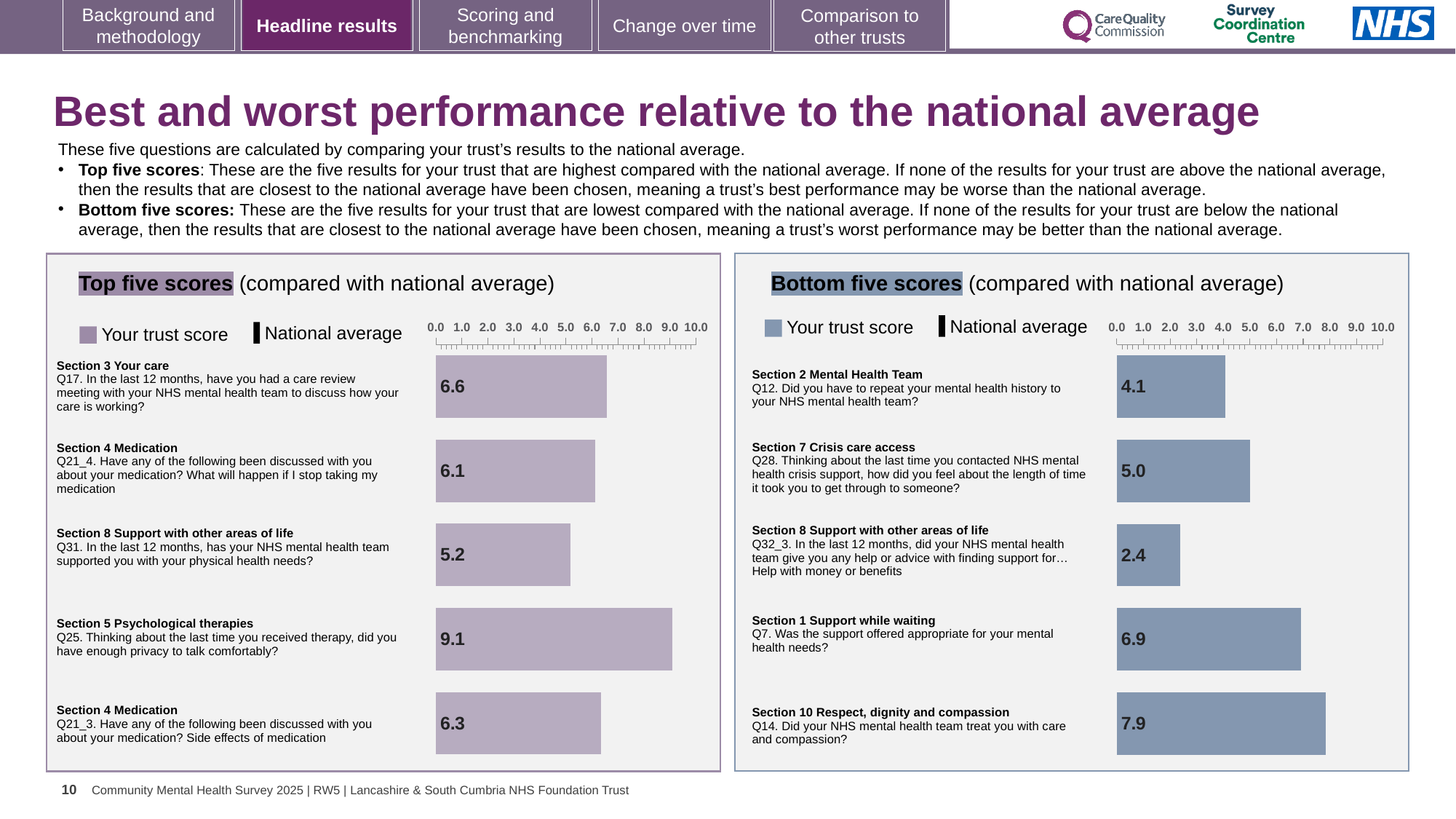
How many series does the legend of the Bottom five scores chart list? 2 In the Top five scores chart, what is the trust score for Q25 (enough privacy to talk comfortably during therapy)? 9.1 In the Top five scores chart, which has the larger trust score, Q21_4 or Q21_3? Q21_3 In the Bottom five scores chart, what is the difference between the trust scores for Q14 and Q12? 3.8 In the Top five scores chart, what is the trust score for Q17 (care review meeting in the last 12 months)? 6.6 What type of chart is used in the Top five scores panel? Bar chart How many bars are plotted in the Bottom five scores chart? 5 In the Bottom five scores chart, which question has the lowest trust score? Q32_3 In the Top five scores chart, which question has the lowest trust score? Q31 In the Bottom five scores chart, what is the trust score for Q32_3 (help with money or benefits)? 2.4 In the Bottom five scores chart, what is the trust score for Q14 (treated with care and compassion)? 7.9 In the Top five scores chart, which question has the highest trust score? Q25